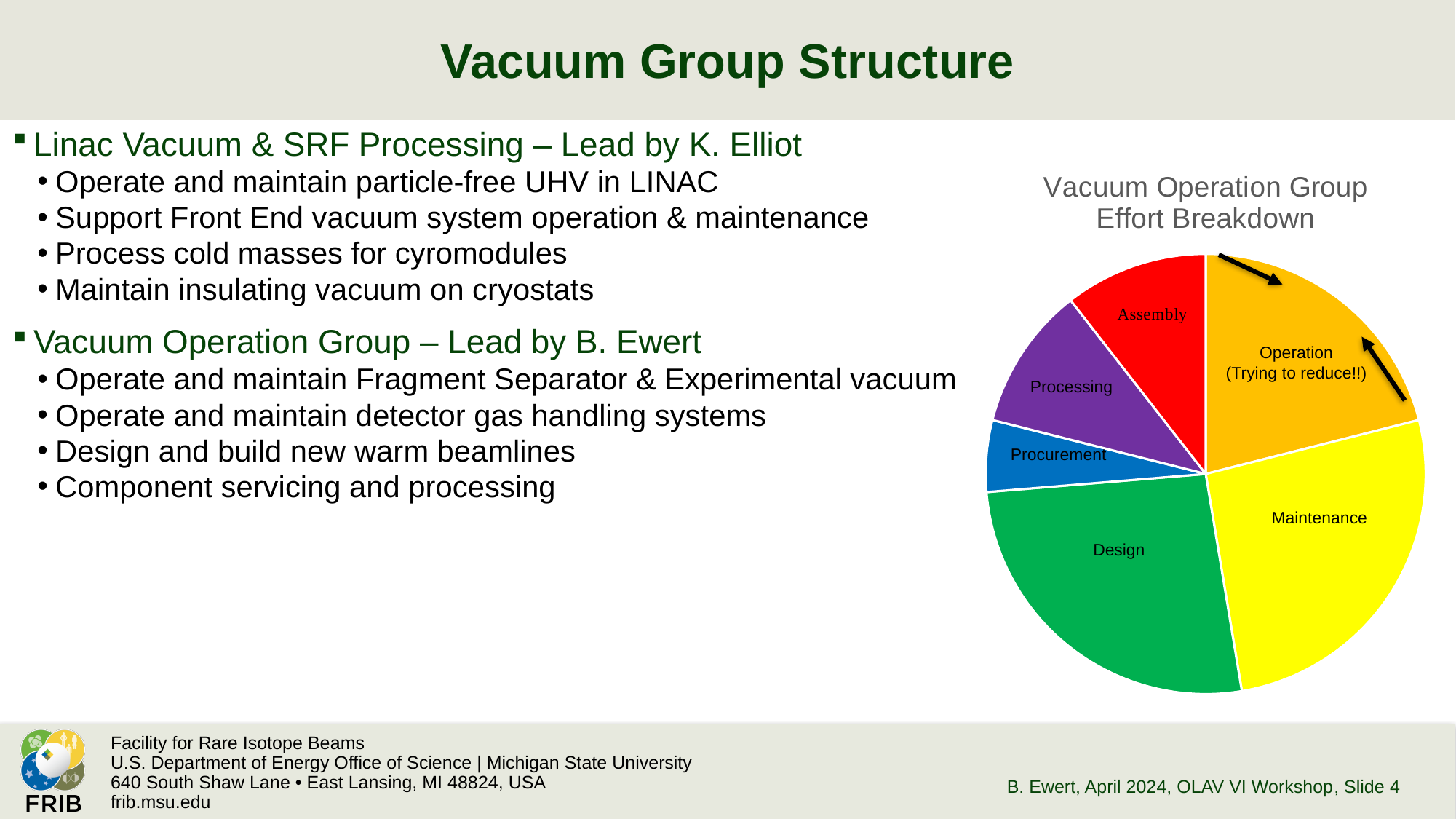
How many slices does the Vacuum Operation Group Effort Breakdown pie chart have? 6 What kind of chart is shown on the slide? pie chart Which slice is larger in the pie chart, Processing or Procurement? Processing Which slice of the pie chart is labelled with the note "Trying to reduce!!"? Operation Which category has the smallest slice in the Vacuum Operation Group Effort Breakdown pie chart? Procurement What is the title of the pie chart on the slide? Vacuum Operation Group Effort Breakdown Which slice is larger in the pie chart, Operation or Assembly? Operation Which slice is larger in the pie chart, Operation or Procurement? Operation